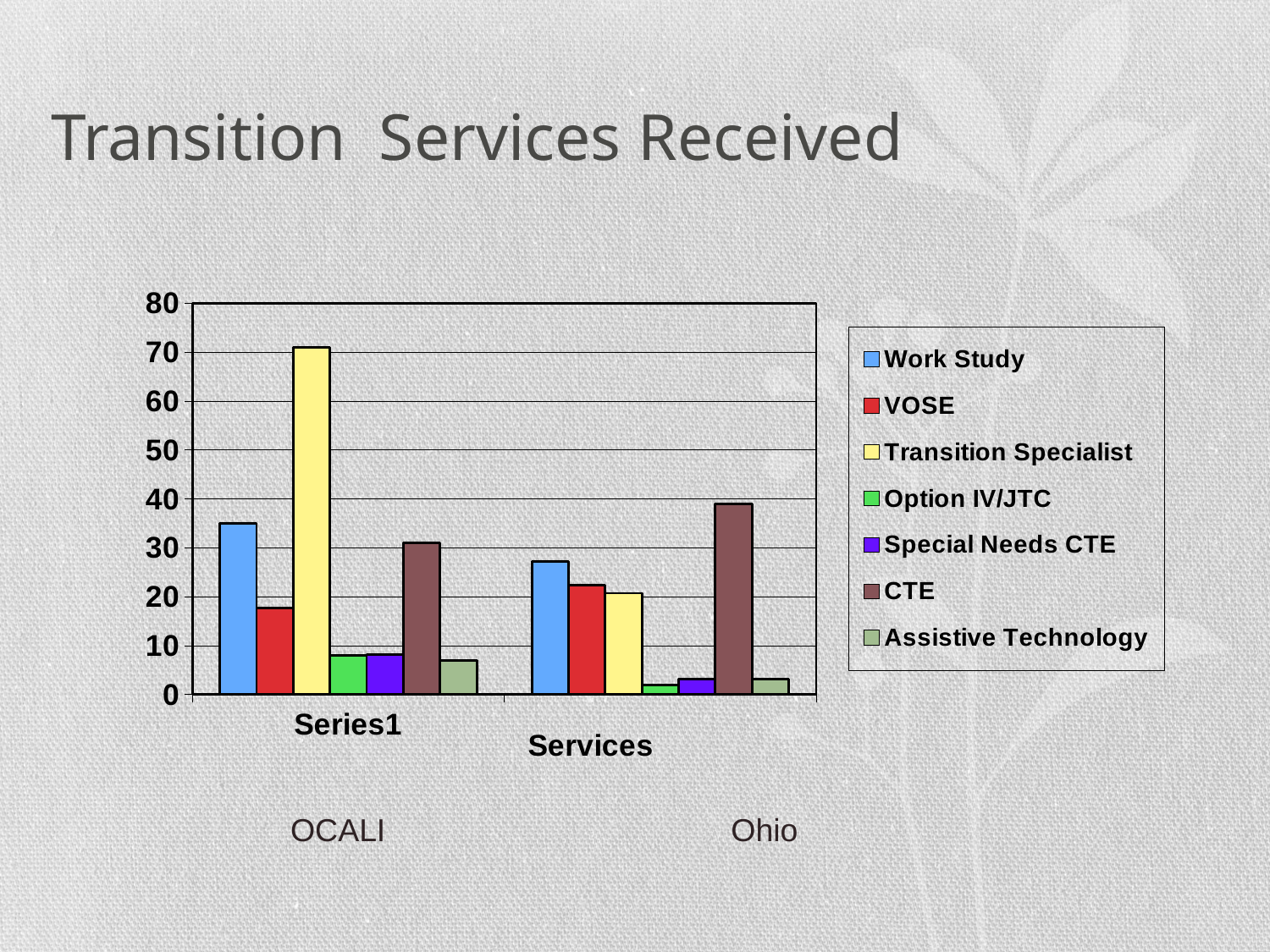
What kind of chart is shown on the slide? bar chart Which is larger for CTE, the Series1 category or the Services category? Services Which is larger in the Series1 category, Work Study or VOSE? Work Study How many categories are shown on the x axis? 2 Which service has the highest bar in the Series1 category? Transition Specialist Is the value for Option IV/JTC in the Services category greater or less than 10? less How many series does the legend list? 7 What is the title of the slide containing the chart? Transition Services Received Which service has the highest bar in the Services category? CTE Is the value for Work Study in the Series1 category greater or less than 30? greater